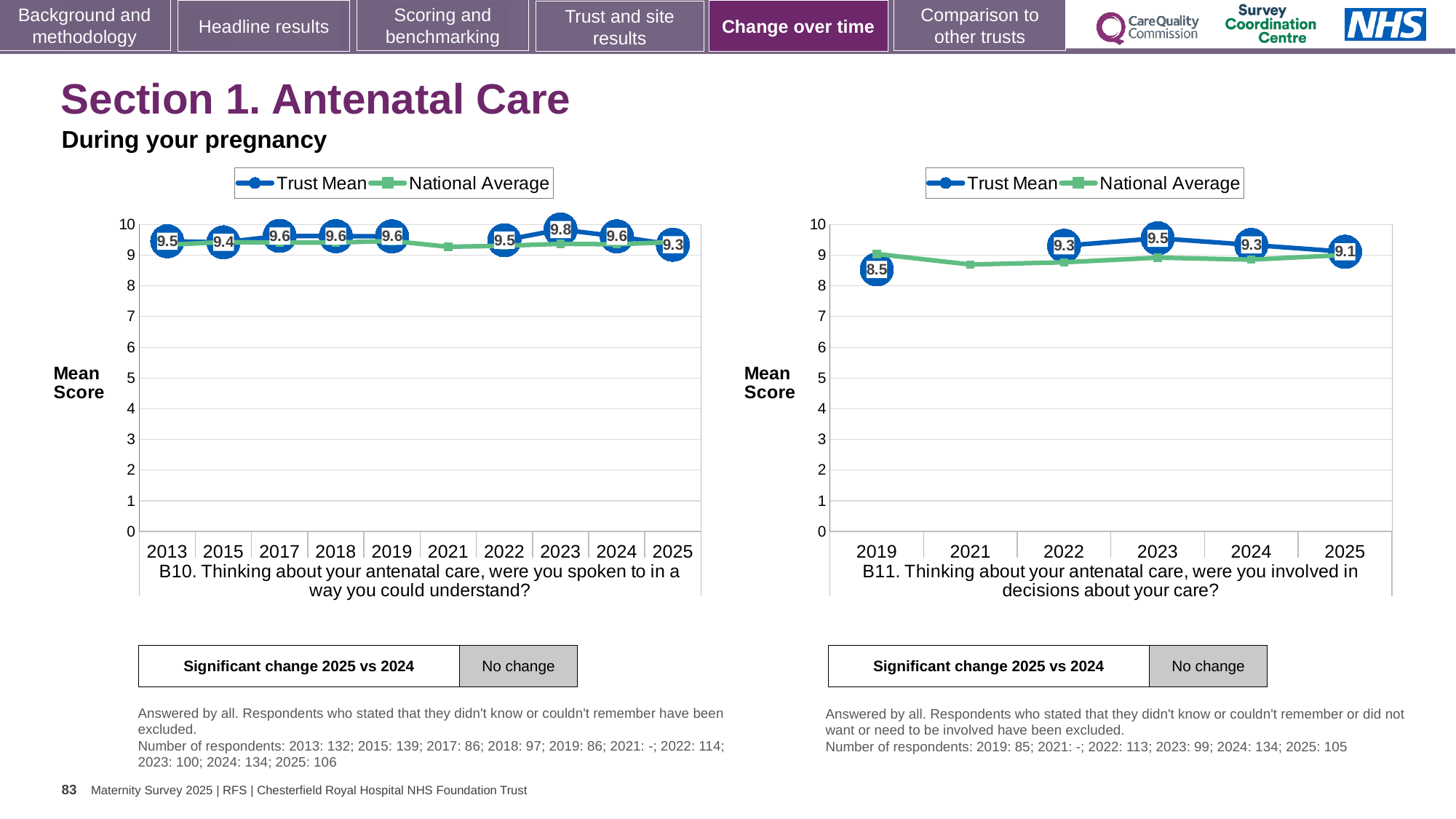
In the B11 chart, what is the difference between the Trust Mean for 2023 and 2025? 0.4 In the B11 chart, what is the Trust Mean for 2019? 8.5 What kind of chart is the B10 chart? Line chart In the B11 chart, which year has the lowest Trust Mean? 2019 In the B10 chart, what is the Trust Mean for 2023? 9.8 In the B10 chart, which year has the highest Trust Mean? 2023 In the B10 chart, what is the Trust Mean for 2025? 9.3 In the B11 chart, what is the Trust Mean for 2023? 9.5 How many years are shown on the x axis of the B11 chart? 6 How many series does the legend of the B10 chart list? 2 In the B11 chart, is the National Average for 2021 greater or less than 8? greater In the B10 chart, which is larger, the Trust Mean for 2023 or for 2025? 2023